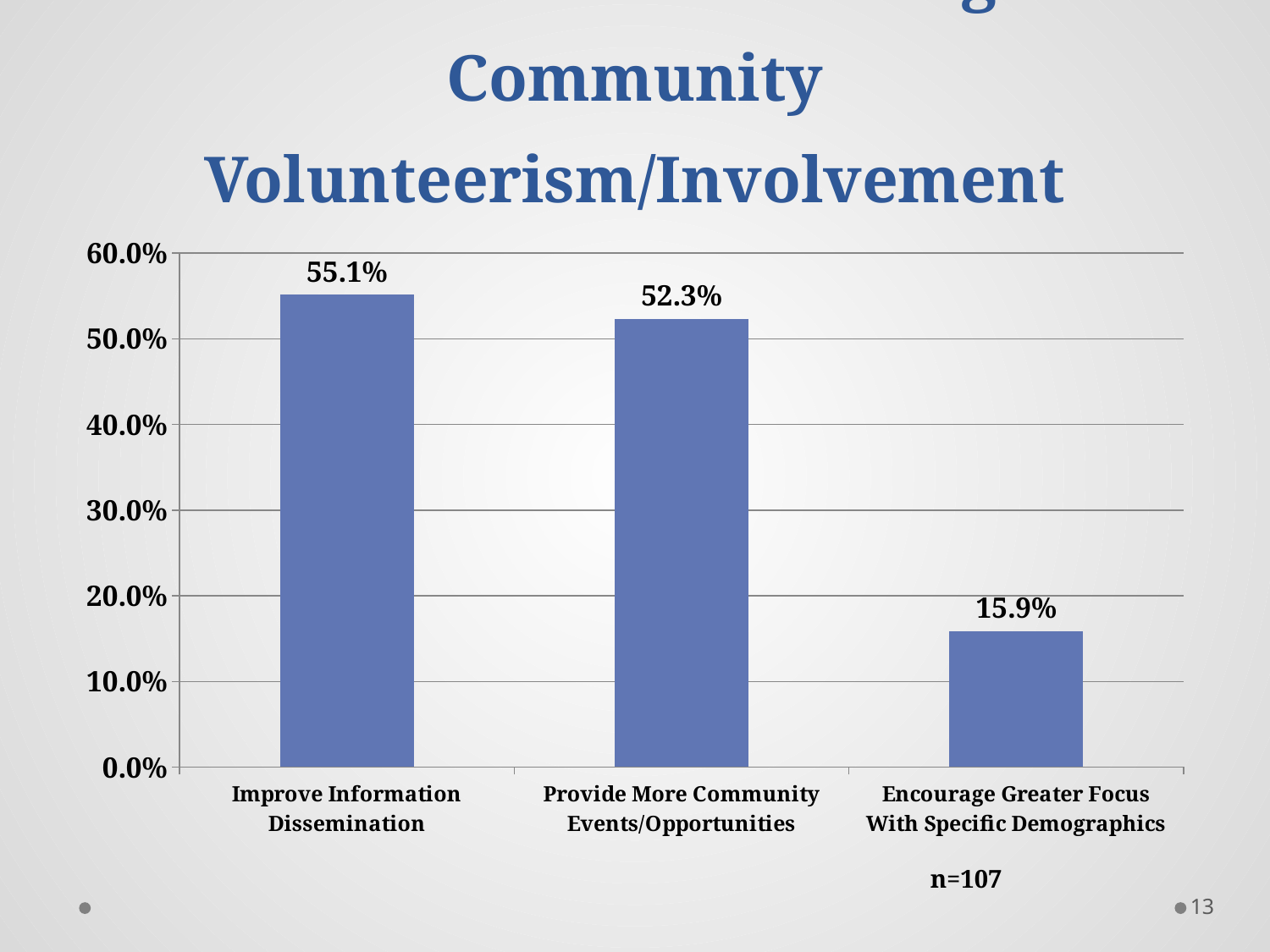
How many categories are shown in the chart? 3 What kind of chart is shown on the slide? bar chart What is the value for Encourage Greater Focus With Specific Demographics? 15.9% What is the difference between the values for Provide More Community Events/Opportunities and Encourage Greater Focus With Specific Demographics? 36.4% Is the value for Encourage Greater Focus With Specific Demographics greater or less than 20.0%? less Which is larger, the value for Provide More Community Events/Opportunities or the value for Encourage Greater Focus With Specific Demographics? Provide More Community Events/Opportunities What is the difference between the values for Improve Information Dissemination and Encourage Greater Focus With Specific Demographics? 39.2% What sample size (n) is noted below the chart? n=107 What is the value for Provide More Community Events/Opportunities? 52.3% What is the value for Improve Information Dissemination? 55.1% Which category has the highest value? Improve Information Dissemination Which category has the lowest value? Encourage Greater Focus With Specific Demographics